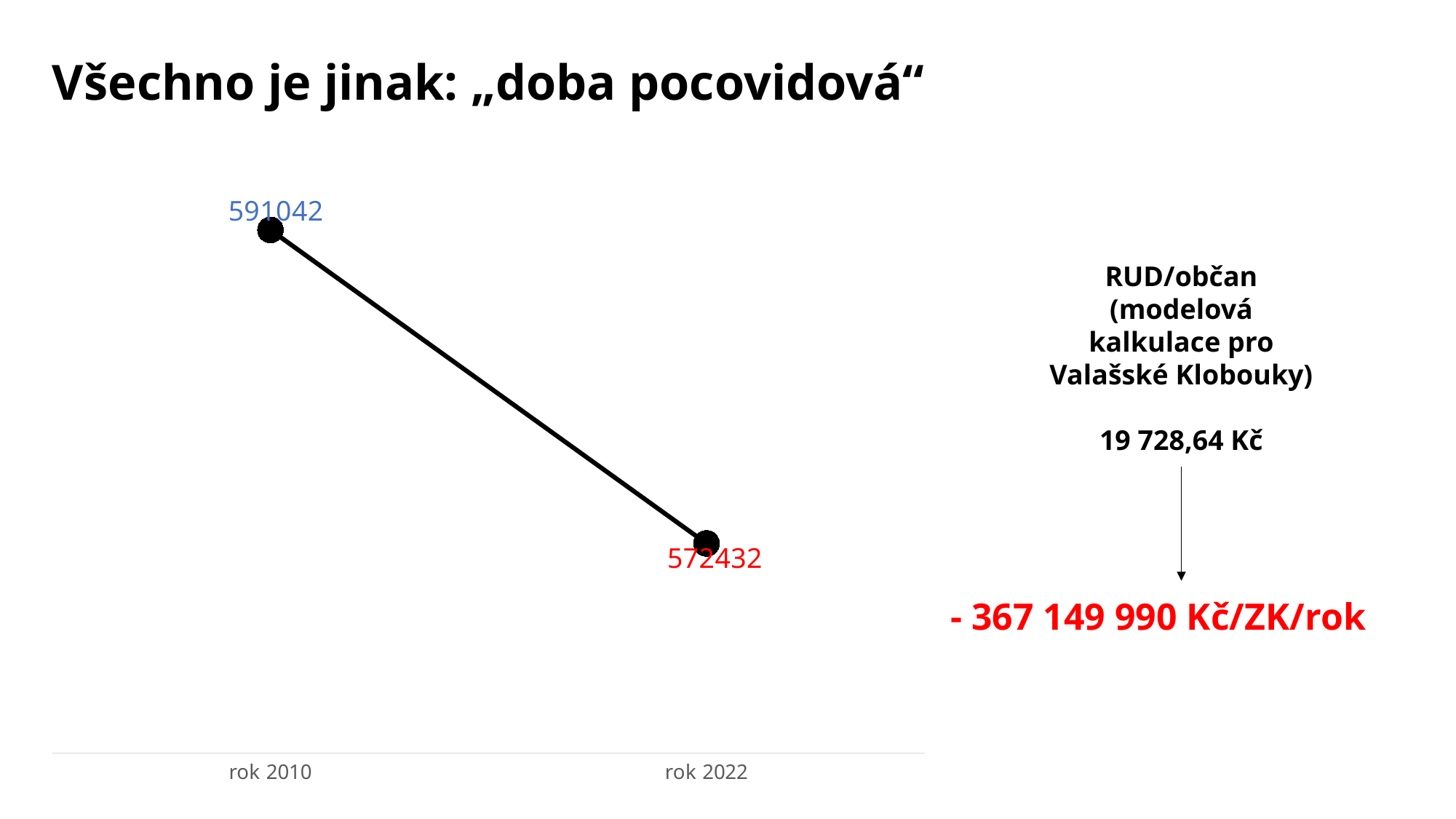
Do the plotted values rise or fall from rok 2010 to rok 2022? fall Which category has the lowest plotted value? rok 2022 What is the value plotted for rok 2010? 591042 How many data points are plotted on the chart? 2 What are the two category labels on the x axis of the chart? rok 2010 and rok 2022 Which year has the higher plotted value, rok 2010 or rok 2022? rok 2010 What colour is the data label for rok 2022? red What is the difference between the value for rok 2010 and the value for rok 2022? 18610 What kind of chart is shown on the slide? line chart Which category has the highest plotted value? rok 2010 What is the value plotted for rok 2022? 572432